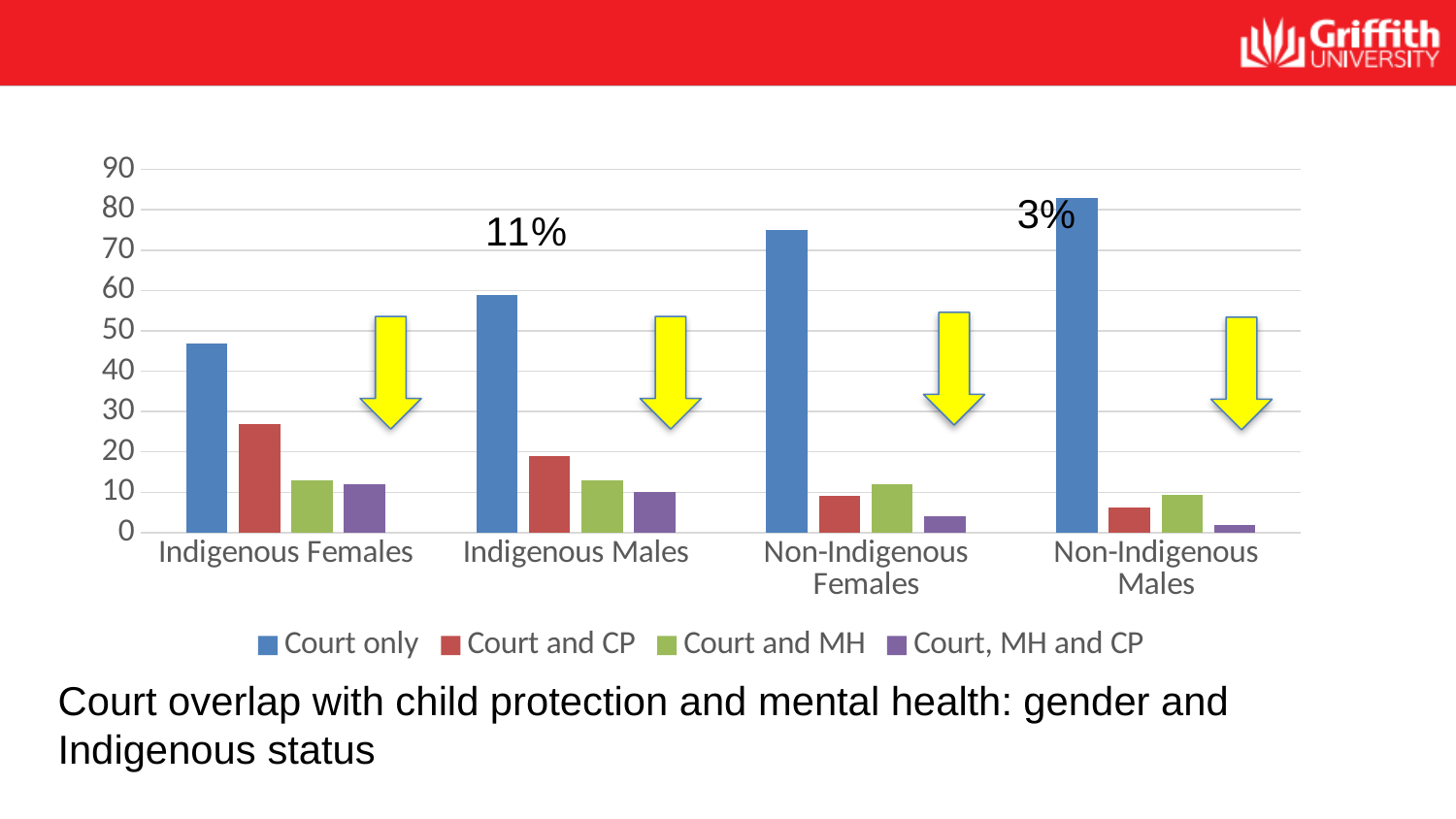
Is the Court only value for Indigenous Females greater or less than 50? less Which category has the highest value for Court and CP? Indigenous Females Which category has the lowest value for Court only? Indigenous Females What colour represents the Court only series in the legend? Blue Is the Court only value for Non-Indigenous Males greater or less than 70? greater Which is larger, the Court and CP value for Indigenous Females or for Indigenous Males? Indigenous Females What kind of chart is shown on the slide? Bar chart How many series does the legend list? 4 Is the Court, MH and CP value for Non-Indigenous Males greater or less than 10? less Do the Court only values rise or fall moving from left to right across the categories? rise Which category has the highest value for Court only? Non-Indigenous Males How many categories are shown on the x axis? 4